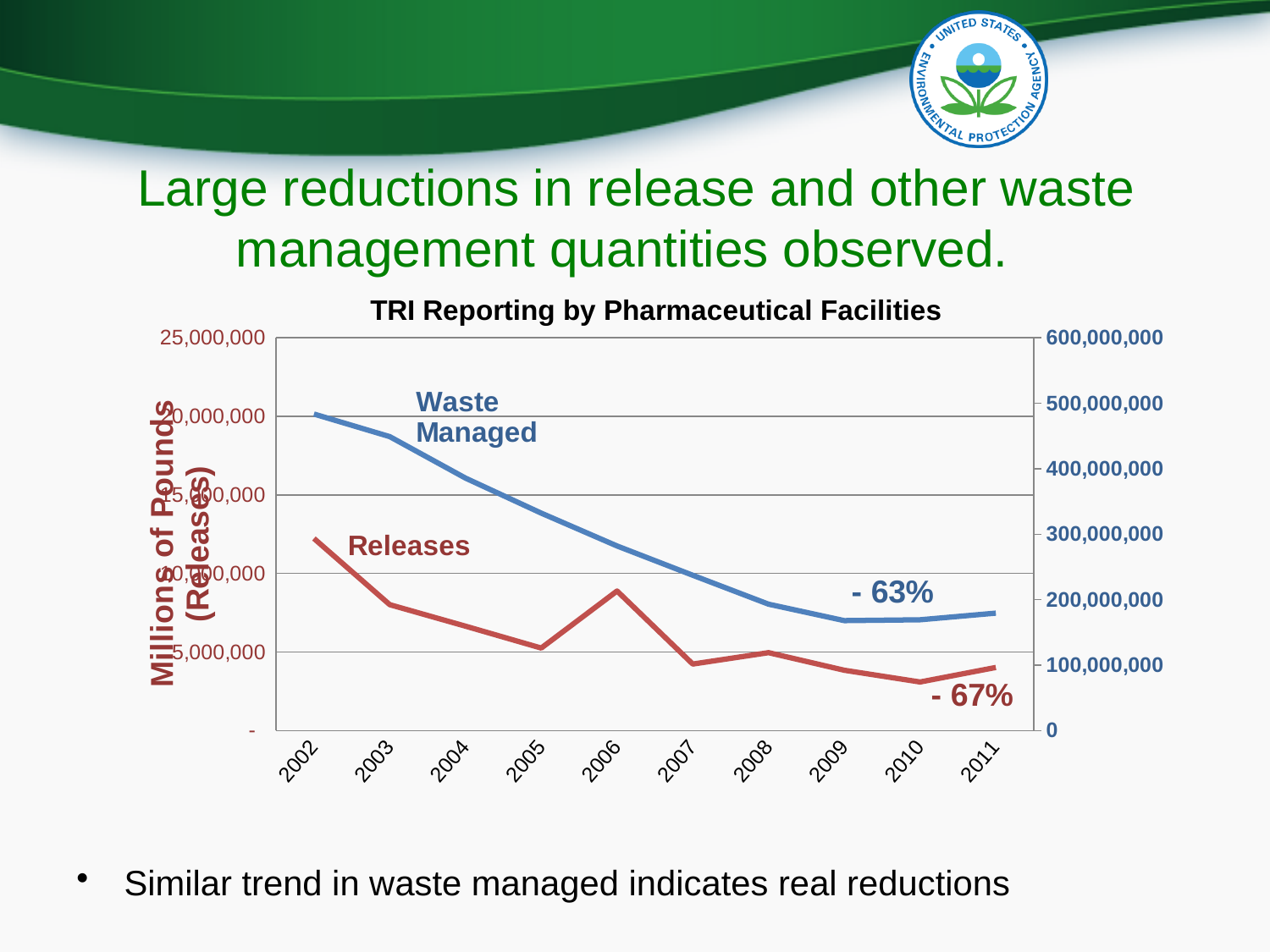
Is the Releases value for 2002 greater or less than 10,000,000? greater What is the title of the chart? TRI Reporting by Pharmaceutical Facilities Is the Waste Managed value for 2011 greater or less than 200,000,000? less In which year is the Releases value highest? 2002 In which year is the Releases value lowest? 2010 What percentage change is annotated for the Waste Managed series? - 63% Do the Releases values generally rise or fall from 2002 to 2011? Fall How many years are shown along the x axis of the chart? 10 What type of chart is shown on the slide? Line chart Which year has the larger Releases value, 2006 or 2007? 2006 How many data series are plotted on the chart? 2 What percentage change is annotated for the Releases series? - 67%